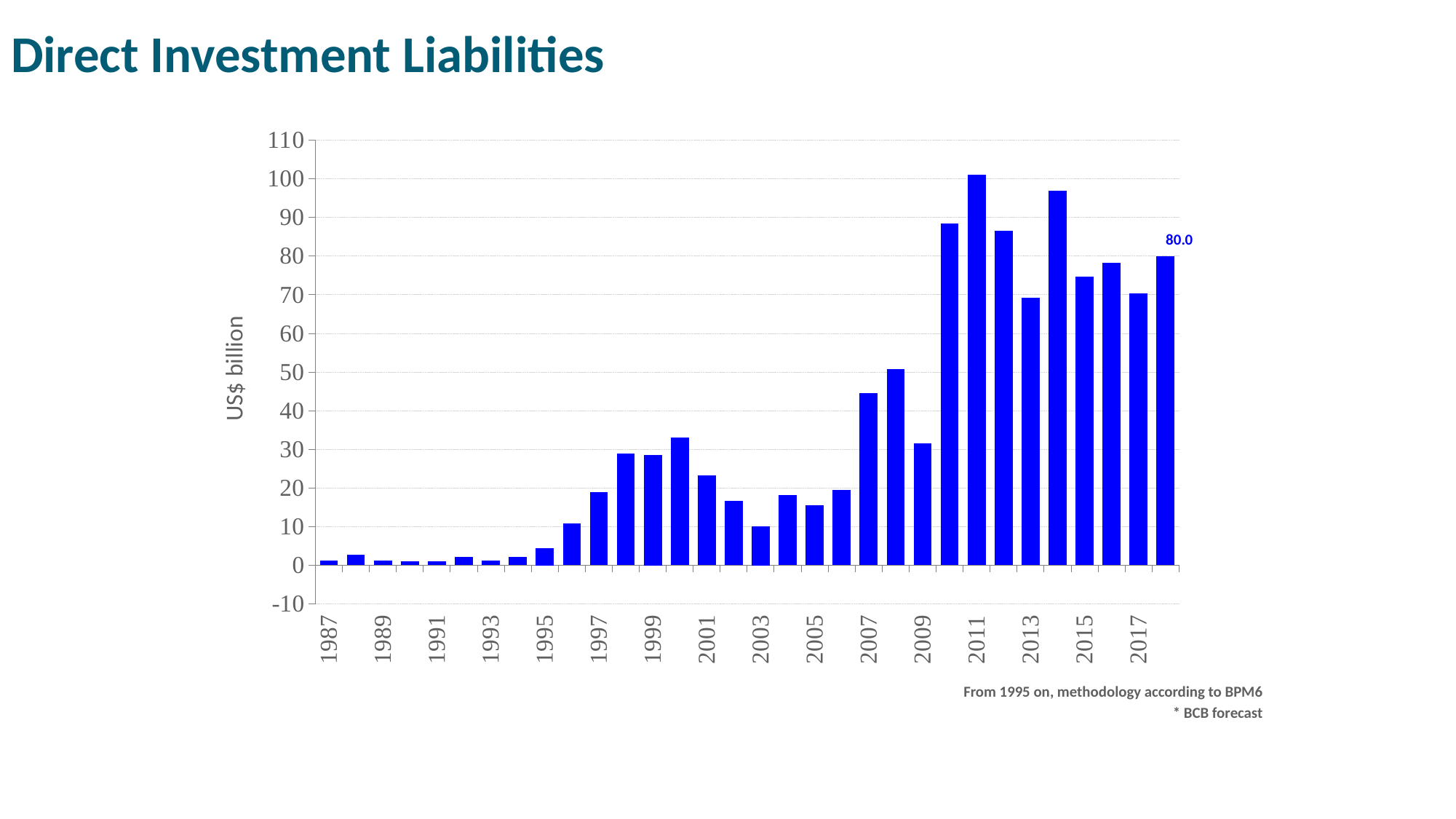
What unit is shown on the vertical axis label? US$ billion Is the value for 2015 greater or less than 80? less Is the value for 2014 greater or less than 90? greater Which year has the highest direct investment liabilities? 2011 What kind of chart is shown on the slide? bar chart Which year has the larger value, 2016 or 2017? 2016 What value is printed as the data label on the last (rightmost) bar? 80.0 What is the title of the chart? Direct Investment Liabilities Is the value for 2007 greater or less than 40? greater Which year has the larger value, 2011 or 2014? 2011 Do the values rise or fall from 2011 to 2013? fall